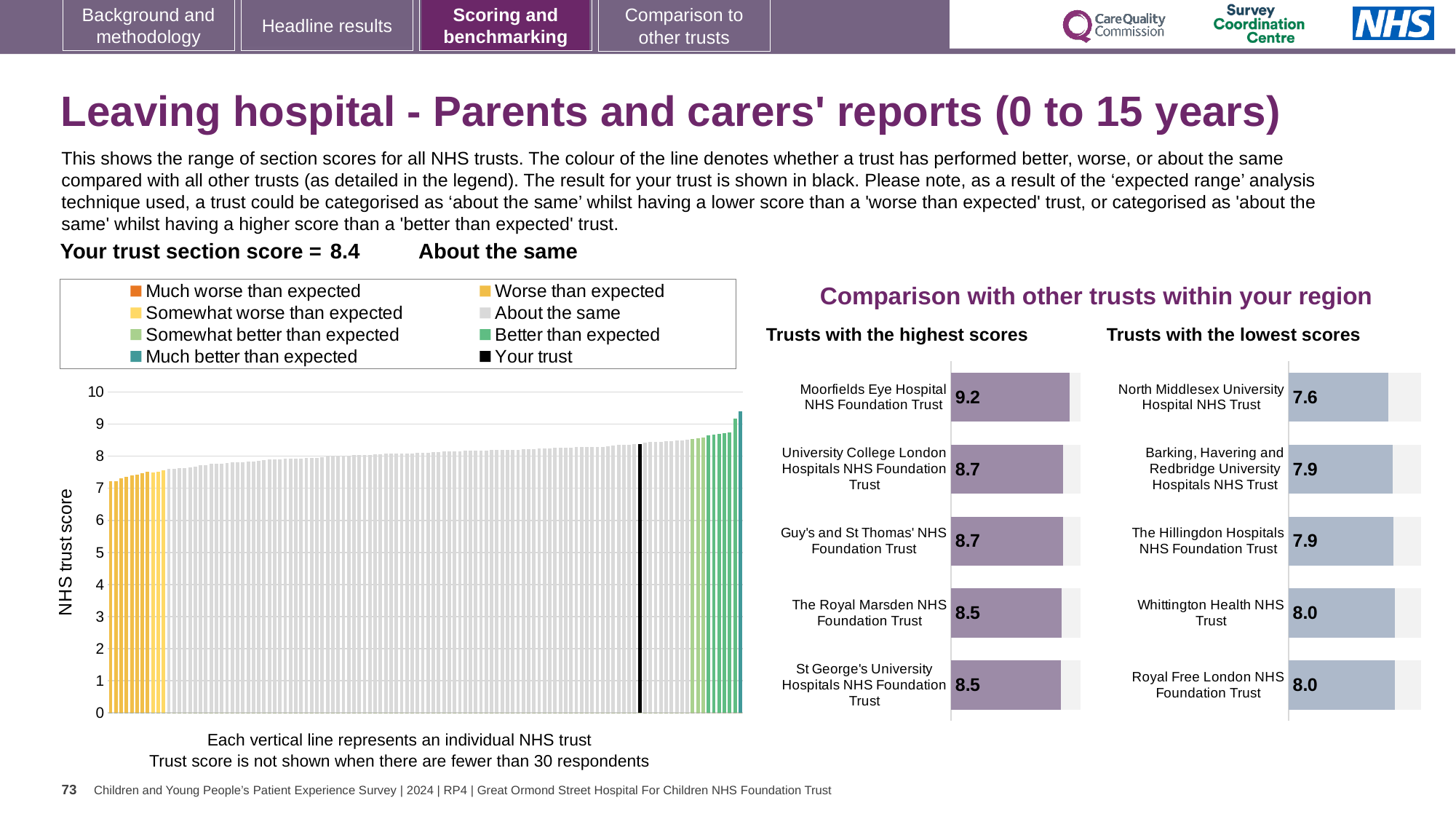
In the 'Trusts with the lowest scores' chart, which has the larger score: The Hillingdon Hospitals NHS Foundation Trust or North Middlesex University Hospital NHS Trust? The Hillingdon Hospitals NHS Foundation Trust In the main chart on the left showing all NHS trusts, what kind of chart is it? Bar chart In the 'Trusts with the highest scores' chart, which trust has the highest score? Moorfields Eye Hospital NHS Foundation Trust In the 'Trusts with the highest scores' chart, what is the score for The Royal Marsden NHS Foundation Trust? 8.5 In the 'Trusts with the lowest scores' chart, what is the difference between the scores of Royal Free London NHS Foundation Trust and North Middlesex University Hospital NHS Trust? 0.4 In the 'Trusts with the lowest scores' chart, what is the score for North Middlesex University Hospital NHS Trust? 7.6 In the 'Trusts with the highest scores' chart, how many trusts are shown? 5 In the 'Trusts with the highest scores' chart, what is the difference between the scores of Moorfields Eye Hospital NHS Foundation Trust and Guy's and St Thomas' NHS Foundation Trust? 0.5 In the 'Trusts with the highest scores' chart, what is the score for Moorfields Eye Hospital NHS Foundation Trust? 9.2 In the 'Trusts with the lowest scores' chart, which trust has the lowest score? North Middlesex University Hospital NHS Trust In the 'Trusts with the lowest scores' chart, what is the score for Whittington Health NHS Trust? 8.0 In the main chart on the left showing all NHS trusts, how many entries does the legend list? 8